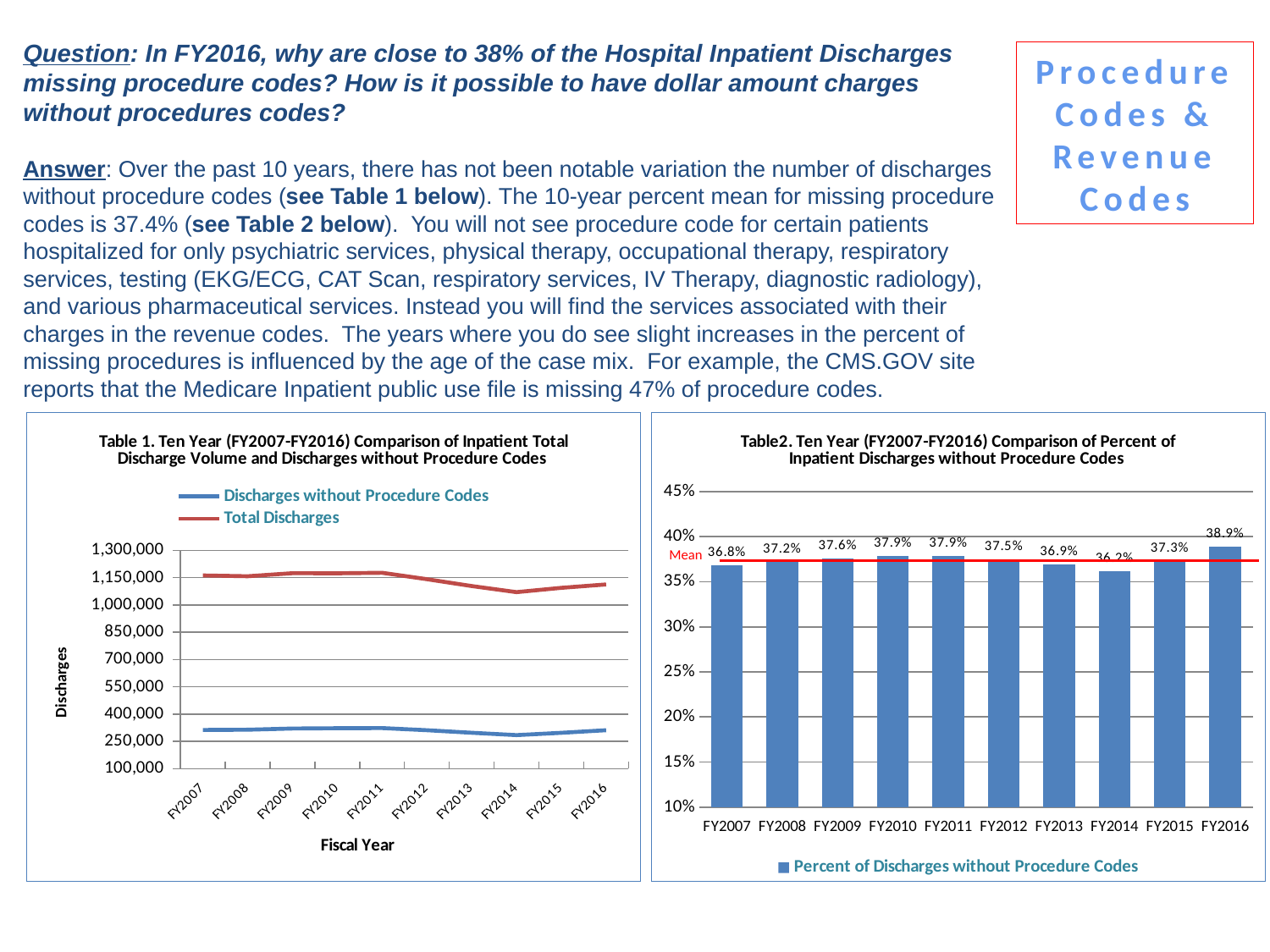
In Table 2, what is the percent of discharges without procedure codes for FY2007? 36.8% How many series does the legend of Table 1 list? 2 In Table 2, which fiscal year has the lowest percent of discharges without procedure codes? FY2014 In Table 2, how many fiscal years are shown on the x axis? 10 In Table 1, is the value for Total Discharges in FY2014 greater or less than 1,150,000? less In Table 2, how much higher is the FY2016 percent than the FY2007 percent? 2.1 percentage points In Table 2, what is the percent of discharges without procedure codes for FY2012? 37.5% In Table 2, what is the percent of discharges without procedure codes for FY2016? 38.9% What kind of chart is Table 2? Bar chart In Table 2, which fiscal year has a higher percent of discharges without procedure codes, FY2009 or FY2013? FY2009 In Table 2, which fiscal year has the highest percent of discharges without procedure codes? FY2016 What kind of chart is Table 1? Line chart